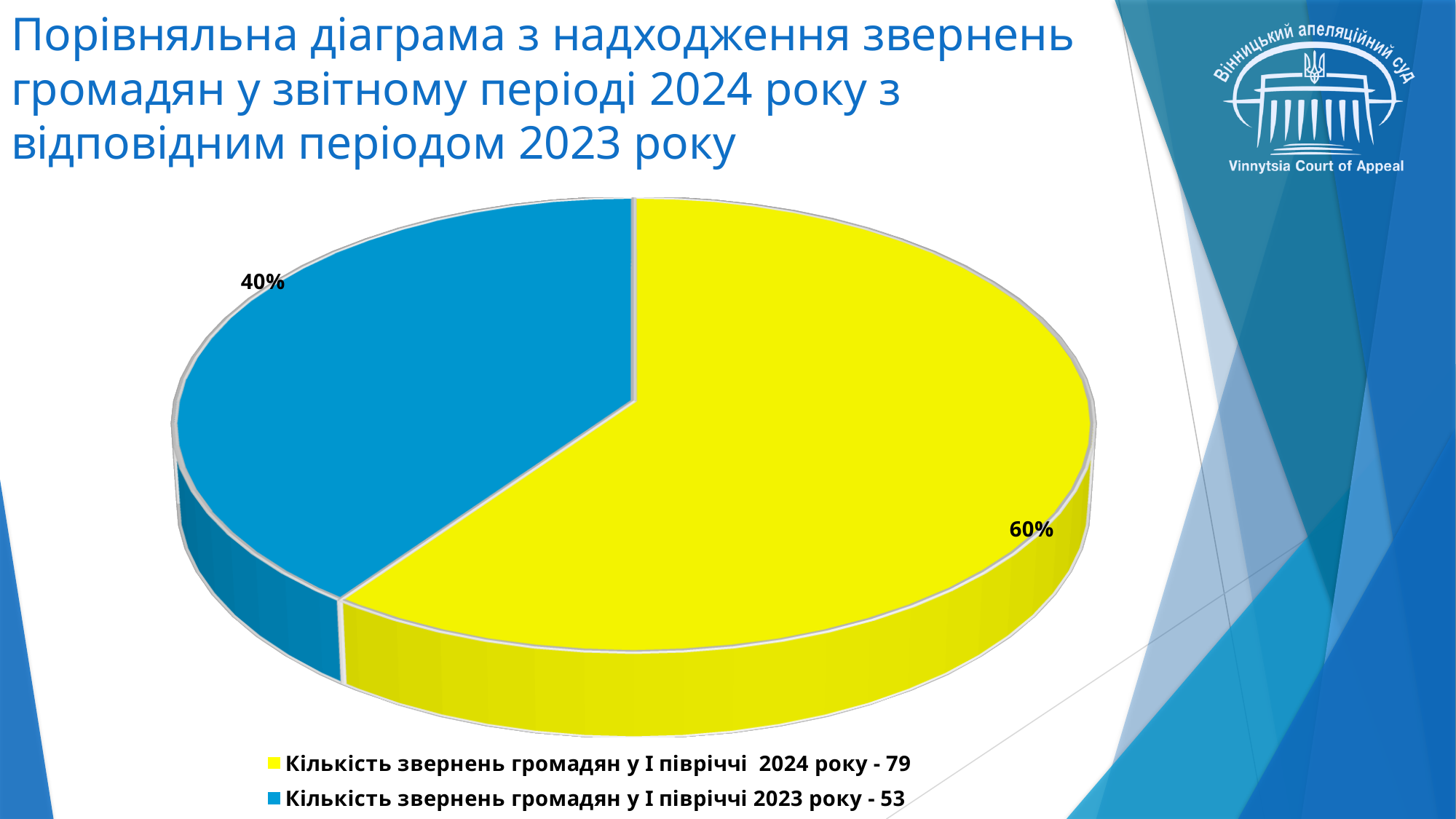
What is the difference in percentage points between the 2024 slice and the 2023 slice? 20 percentage points According to the legend, how many citizens' appeals were received in the first half of 2024? 79 What colour is the slice representing the first half of 2023? blue According to the legend, how many citizens' appeals were received in the first half of 2023? 53 Which slice is the largest in the pie chart? Кількість звернень громадян у І півріччі 2024 року - 79 Which slice is the smallest in the pie chart? Кількість звернень громадян у І півріччі 2023 року - 53 Which is larger: the share for the first half of 2024 or the share for the first half of 2023? first half of 2024 What share of the pie is the slice for the number of citizens' appeals in the first half of 2023? 40% What kind of chart is shown on the slide? pie chart How many entries does the legend list? 2 What share of the pie is the slice for the number of citizens' appeals in the first half of 2024? 60% How many slices does the pie chart have? 2